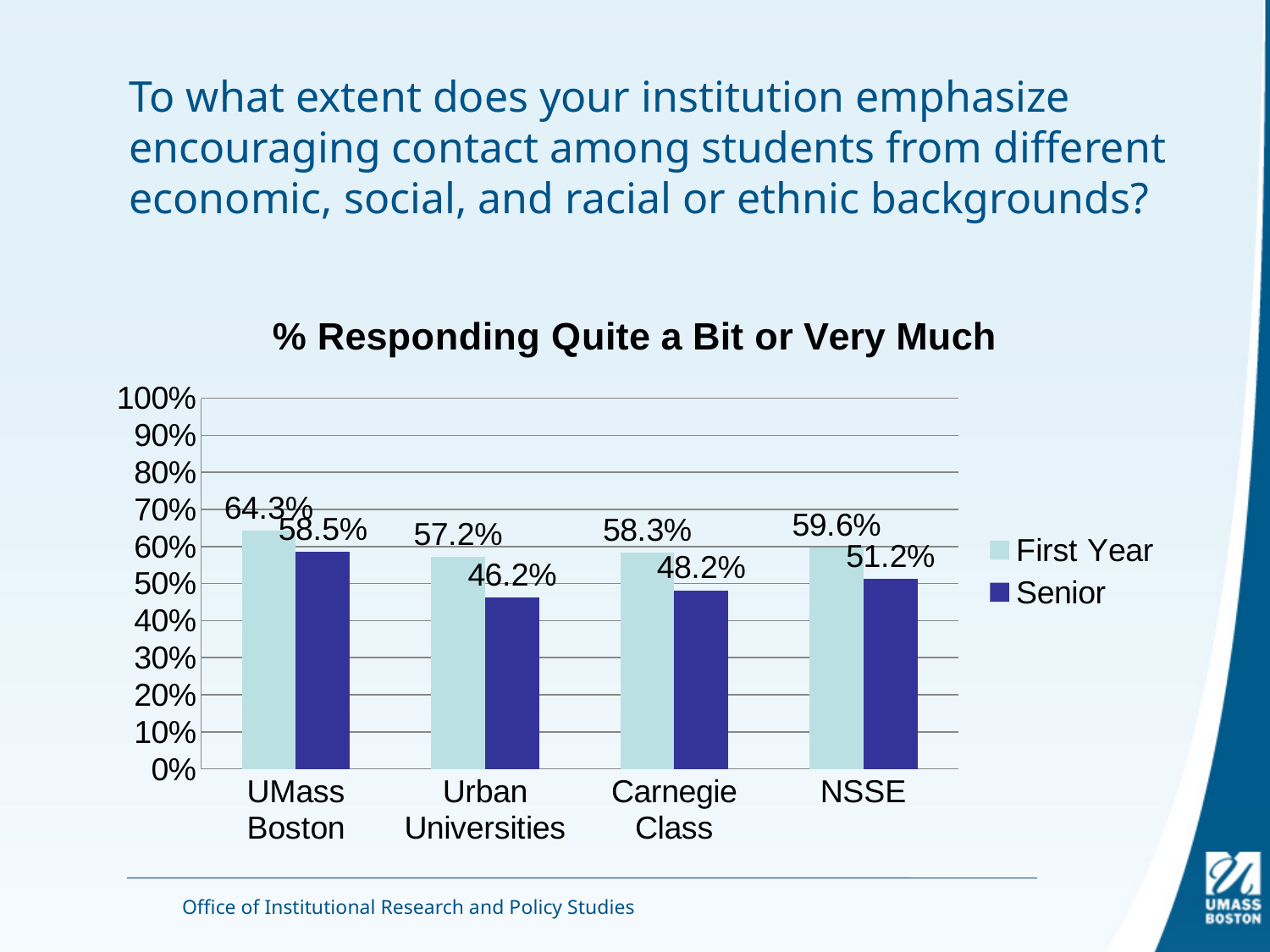
What is the difference between the First Year and Senior values for Carnegie Class? 10.1% How many series does the legend list? 2 What kind of chart is shown on the slide? bar chart What is the Senior value for Urban Universities? 46.2% Is the First Year value for Urban Universities greater or less than 50%? greater What is the title of the chart? % Responding Quite a Bit or Very Much How many categories are shown on the x axis? 4 Which category has the highest First Year value? UMass Boston What is the Senior value for NSSE? 51.2% Which is larger: the Senior value for UMass Boston or the Senior value for NSSE? UMass Boston Which category has the lowest Senior value? Urban Universities What is the First Year value for UMass Boston? 64.3%